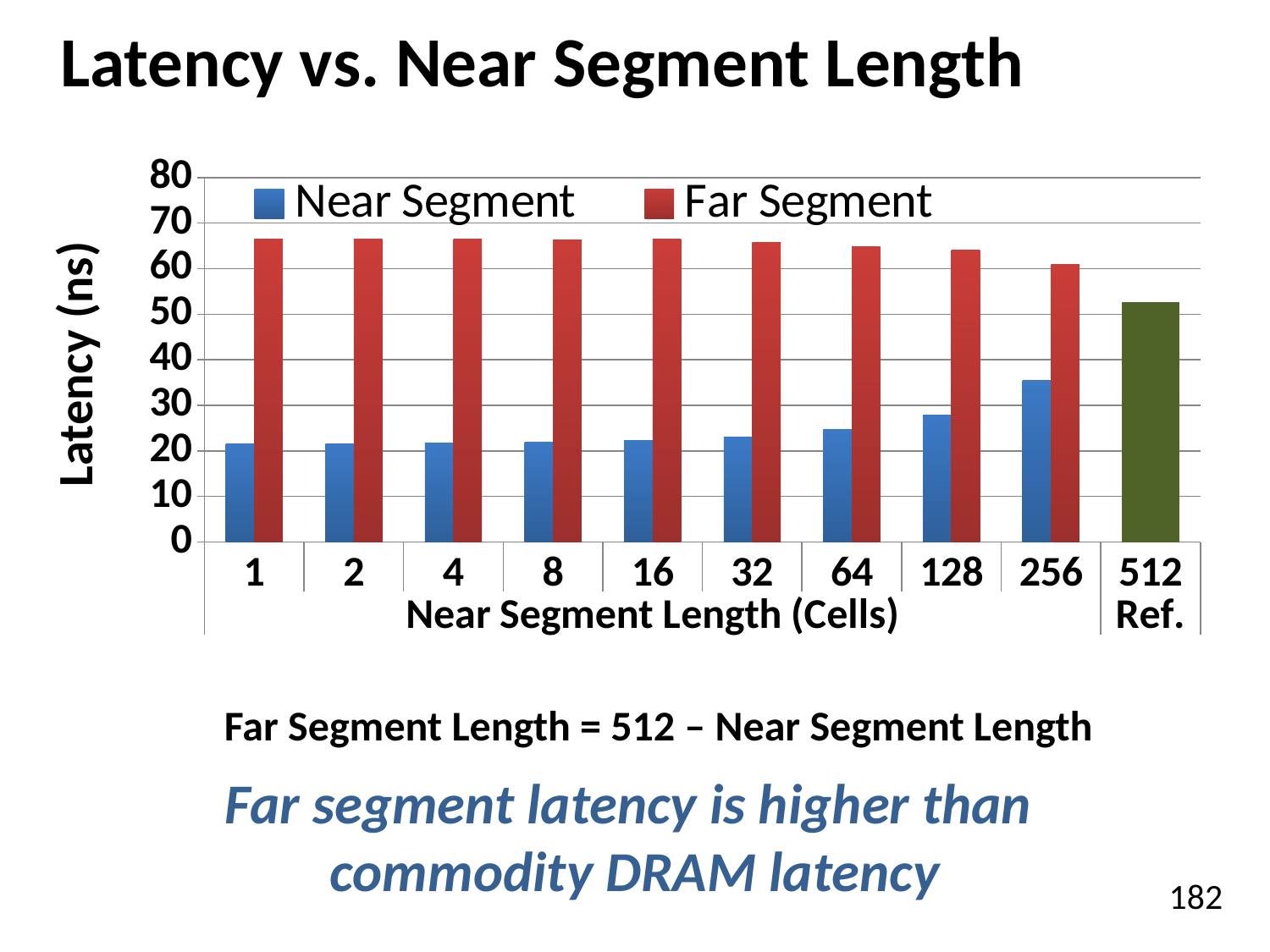
Is the Near Segment latency at a near segment length of 1 cell greater or less than 20? greater What kind of chart is shown on the slide? bar chart Is the Near Segment latency at a near segment length of 128 cells greater or less than 30? less Which is larger at a near segment length of 1 cell: the Near Segment latency or the Far Segment latency? Far Segment At which near segment length is the Near Segment latency highest? 256 Does the Near Segment latency rise or fall as the near segment length increases along the x axis? rise Which is larger: the Far Segment latency at 256 cells or the 512 Ref. latency? Far Segment latency at 256 cells Is the Near Segment latency at a near segment length of 256 cells greater or less than 40? less How many series does the legend list? 2 How many categories are shown along the x axis? 10